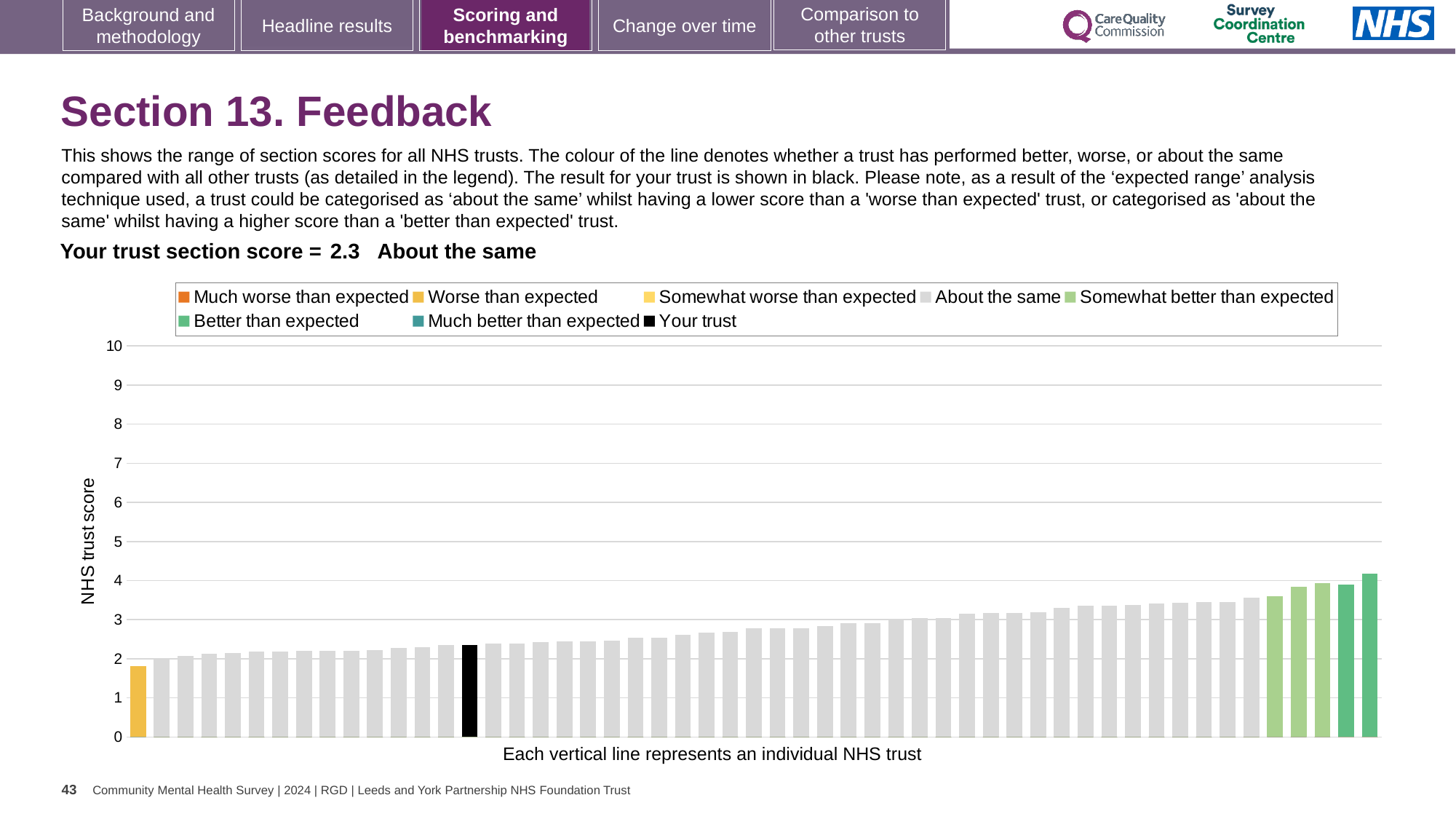
How many entries does the chart legend list? 8 Is the value of the leftmost (yellow) bar greater or less than 2? less Is the value of the black bar (your trust) greater or less than 3? less Do the bar values rise or fall from left to right along the x axis? rise What kind of chart is shown on the slide? bar chart What is the highest value shown on the y axis? 10 How is your trust categorised compared with other trusts for Section 13? About the same Is the value of the black bar (your trust) greater or less than 2? greater How many bars are coloured as 'Worse than expected' (yellow)? 1 What is the section score for your trust shown on the slide? 2.3 What is the label of the y axis? NHS trust score